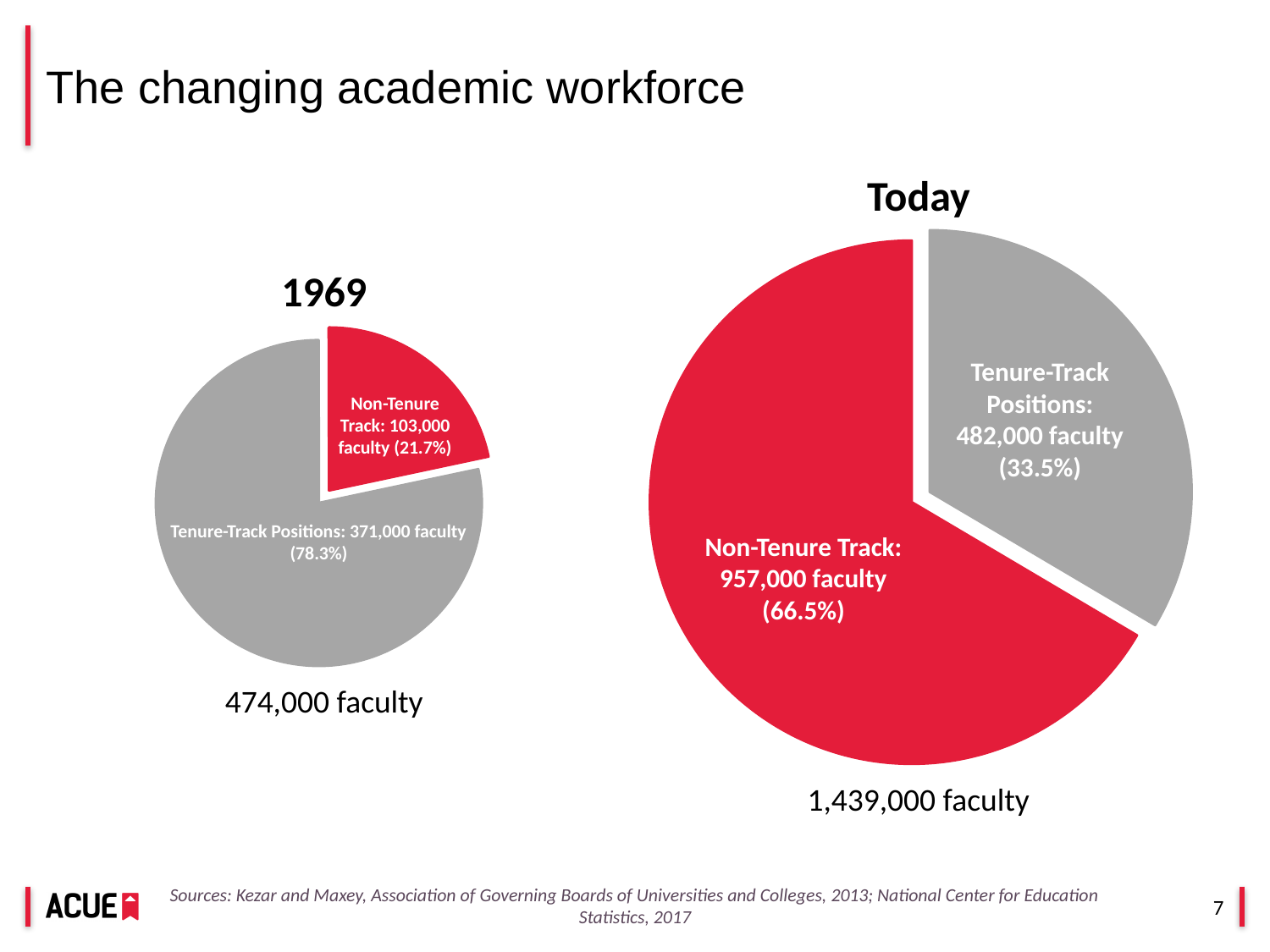
How many slices does the 1969 pie chart have? 2 What type of chart is used on this slide? Pie chart In the Today pie chart, what colour is the Non-Tenure Track slice? Red In the Today pie chart, what share of faculty are in Tenure-Track Positions? 33.5% In the 1969 pie chart, what share of faculty were in Tenure-Track Positions? 78.3% In the Today pie chart, which category has the larger slice? Non-Tenure Track In the 1969 pie chart, which category has the smaller slice? Non-Tenure Track What is the total number of faculty shown for the Today pie chart? 1,439,000 faculty In the Today pie chart, how many faculty are in Non-Tenure Track positions? 957,000 In the 1969 pie chart, how many faculty were in Non-Tenure Track positions? 103,000 In the 1969 pie chart, what is the difference in faculty between Tenure-Track Positions and Non-Tenure Track? 268,000 In the Today pie chart, what is the difference in faculty between Non-Tenure Track and Tenure-Track Positions? 475,000